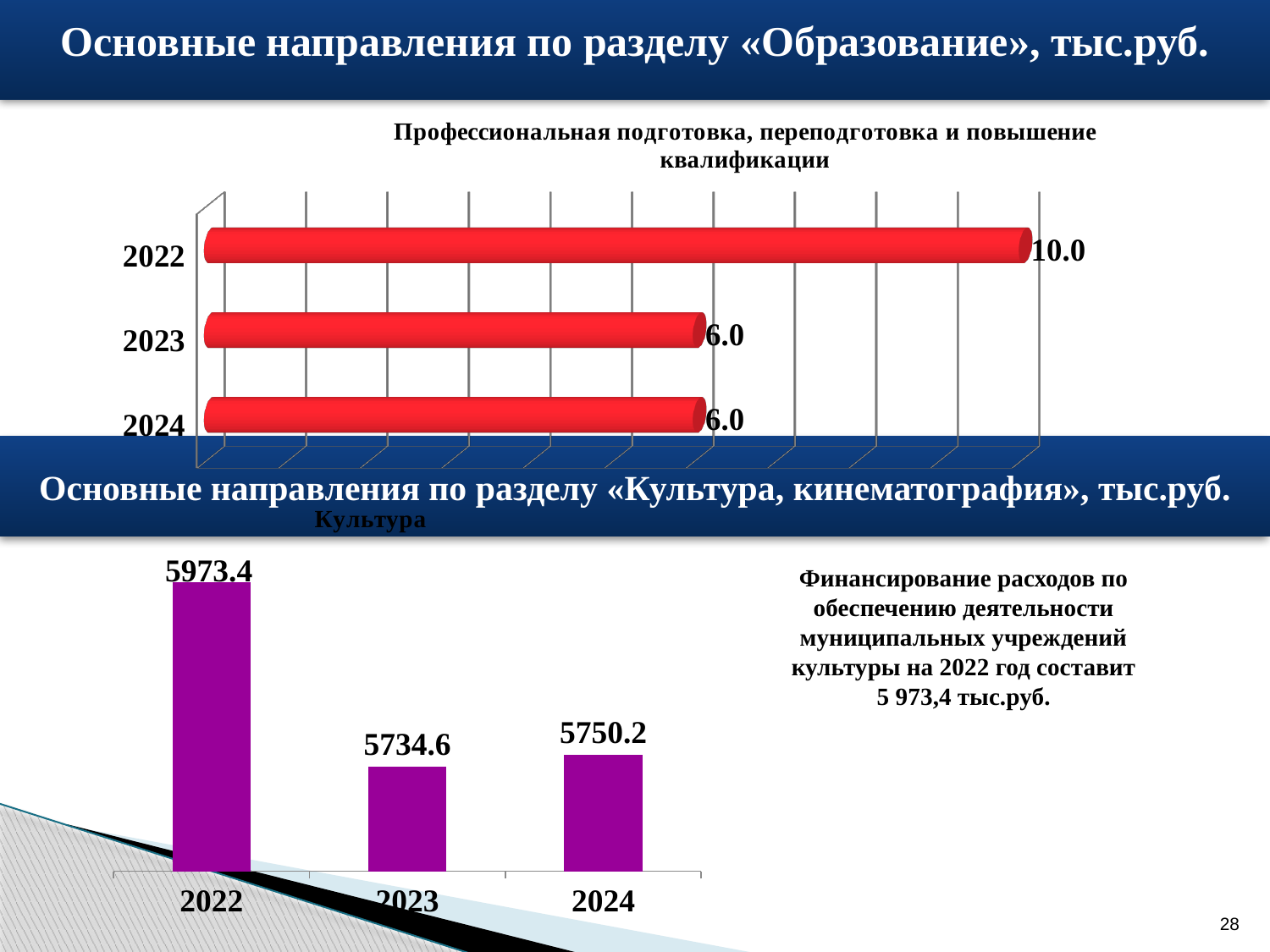
In the top chart 'Профессиональная подготовка, переподготовка и повышение квалификации', how many years are shown? 3 In the top chart 'Профессиональная подготовка, переподготовка и повышение квалификации', what is the value for 2022? 10.0 In the bottom chart 'Культура', which year has the lowest value? 2023 In the bottom chart 'Культура', what is the difference between the values for 2022 and 2023? 238.8 In the bottom chart 'Культура', what is the value for 2024? 5750.2 What kind of chart is the top chart 'Профессиональная подготовка, переподготовка и повышение квалификации'? Bar chart What colour are the bars in the bottom chart 'Культура'? Purple In the top chart 'Профессиональная подготовка, переподготовка и повышение квалификации', what is the difference between the values for 2022 and 2024? 4.0 In the top chart 'Профессиональная подготовка, переподготовка и повышение квалификации', what is the value for 2023? 6.0 In the bottom chart 'Культура', what is the value for 2022? 5973.4 In the top chart 'Профессиональная подготовка, переподготовка и повышение квалификации', which year has the highest value? 2022 In the bottom chart 'Культура', which is larger, the value for 2023 or the value for 2024? 2024